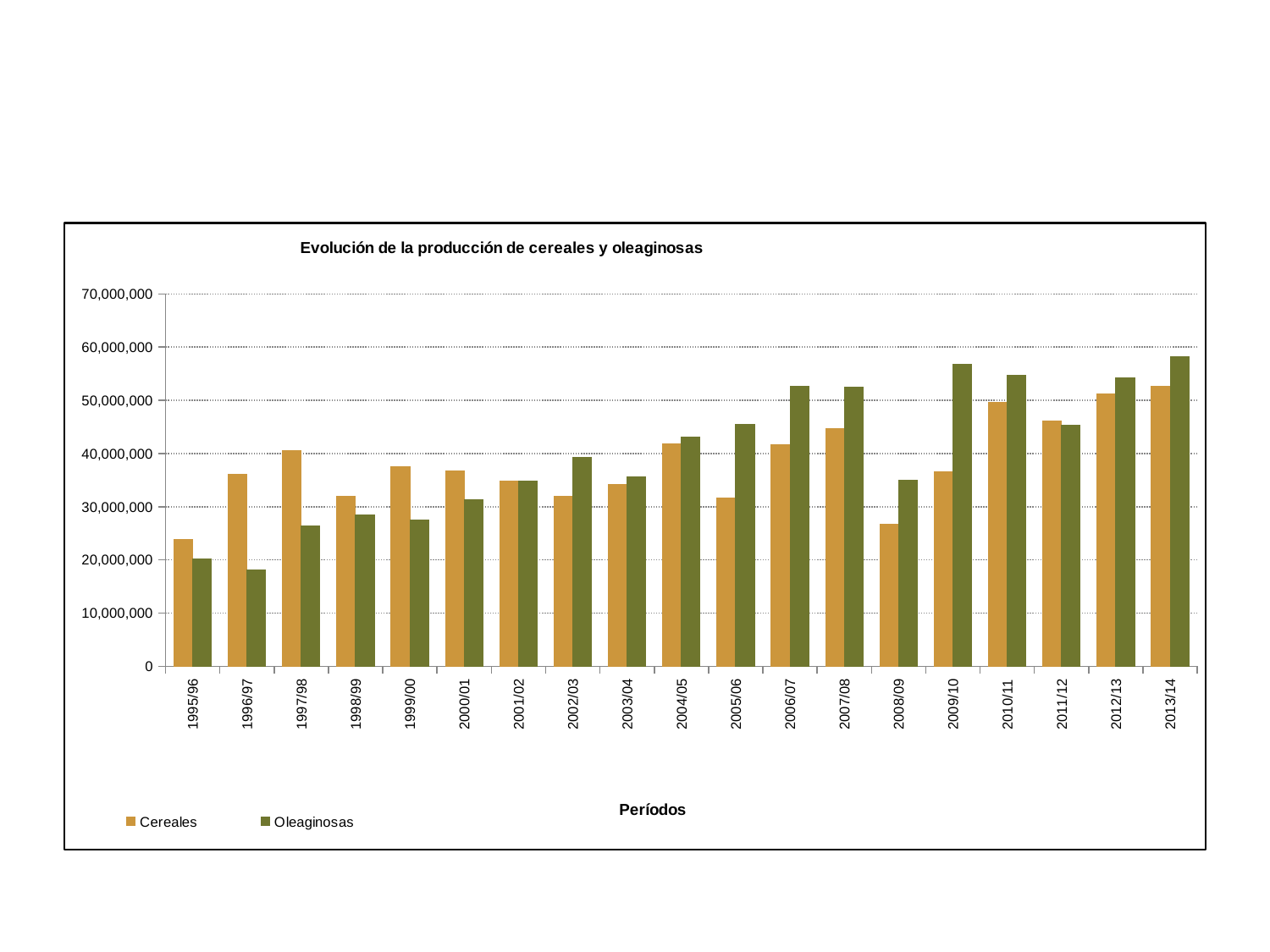
In 1997/98, which is larger, Cereales or Oleaginosas? Cereales In which period is the Oleaginosas value highest? 2013/14 How many series does the legend list? 2 How many periods are shown on the x axis? 19 Is the Cereales value for 2008/09 greater or less than 30,000,000? less In which period is the Oleaginosas value lowest? 1996/97 In 2009/10, which is larger, Cereales or Oleaginosas? Oleaginosas In which period is the Cereales value lowest? 1995/96 Overall, do the Oleaginosas values rise or fall from 1995/96 to 2013/14? rise What kind of chart is shown on the slide? Bar chart Is the Oleaginosas value for 2013/14 greater or less than 50,000,000? greater What is the title of the chart? Evolución de la producción de cereales y oleaginosas